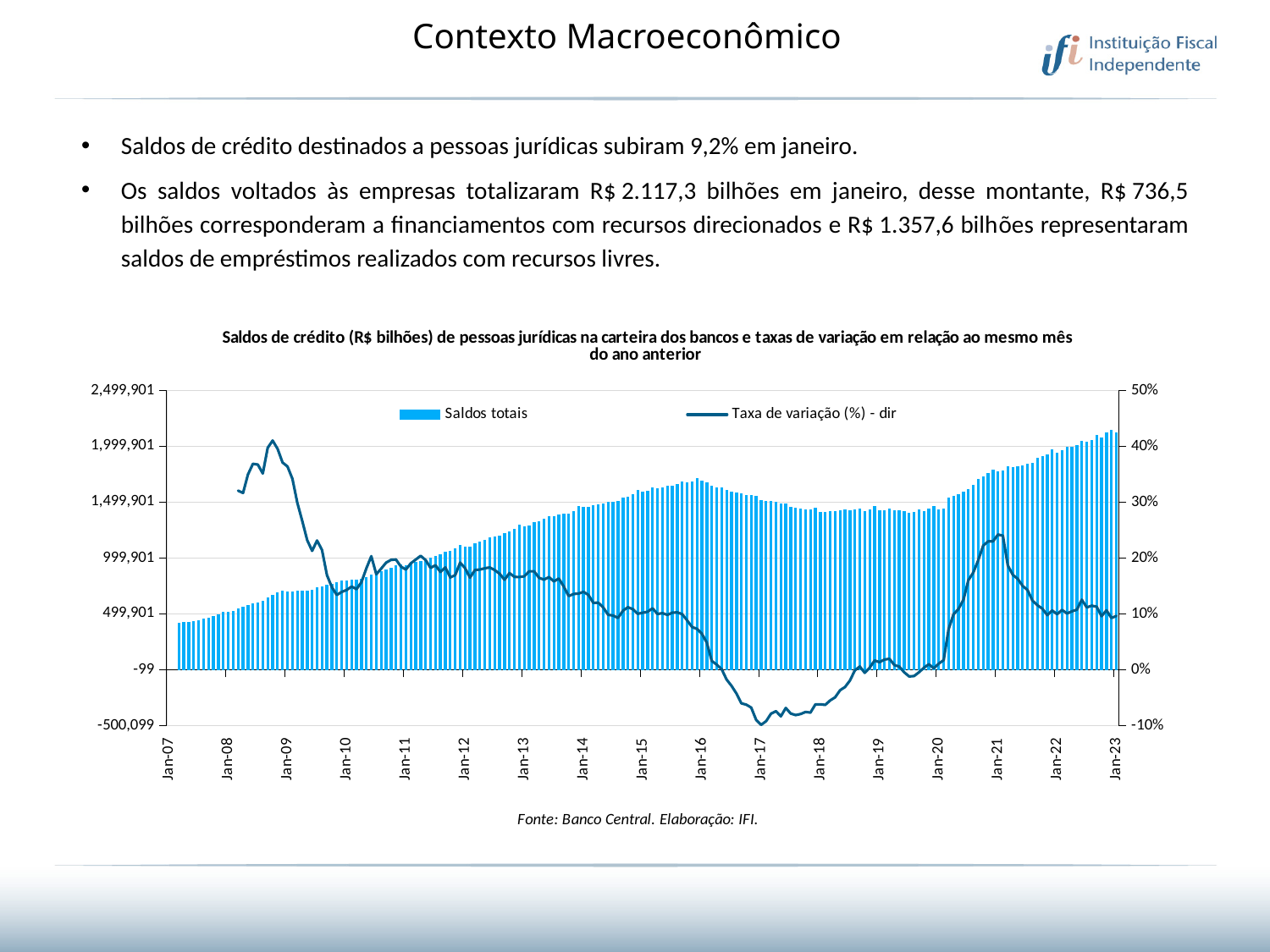
Which series is plotted as bars in the chart? Saldos totais How many series does the chart legend list? 2 Which series is plotted on the right-hand (secondary) axis? Taxa de variação (%) - dir Which is larger: the Saldos totais bar at Jan-23 or at Jan-07? Jan-23 Which is larger: the Taxa de variação (%) value at Jan-21 or at Jan-17? Jan-21 Is the Saldos totais value at Jan-23 greater or less than 1,999,901? greater Is the Taxa de variação (%) value at Jan-17 greater or less than 0%? less Is the Taxa de variação (%) value at Jan-09 greater or less than 30%? greater What kind of chart is shown on the slide? Combined bar and line chart Around which year does the Taxa de variação (%) line reach its lowest point? Jan-17 Do the Saldos totais bars generally rise or fall from Jan-07 to Jan-23? Rise